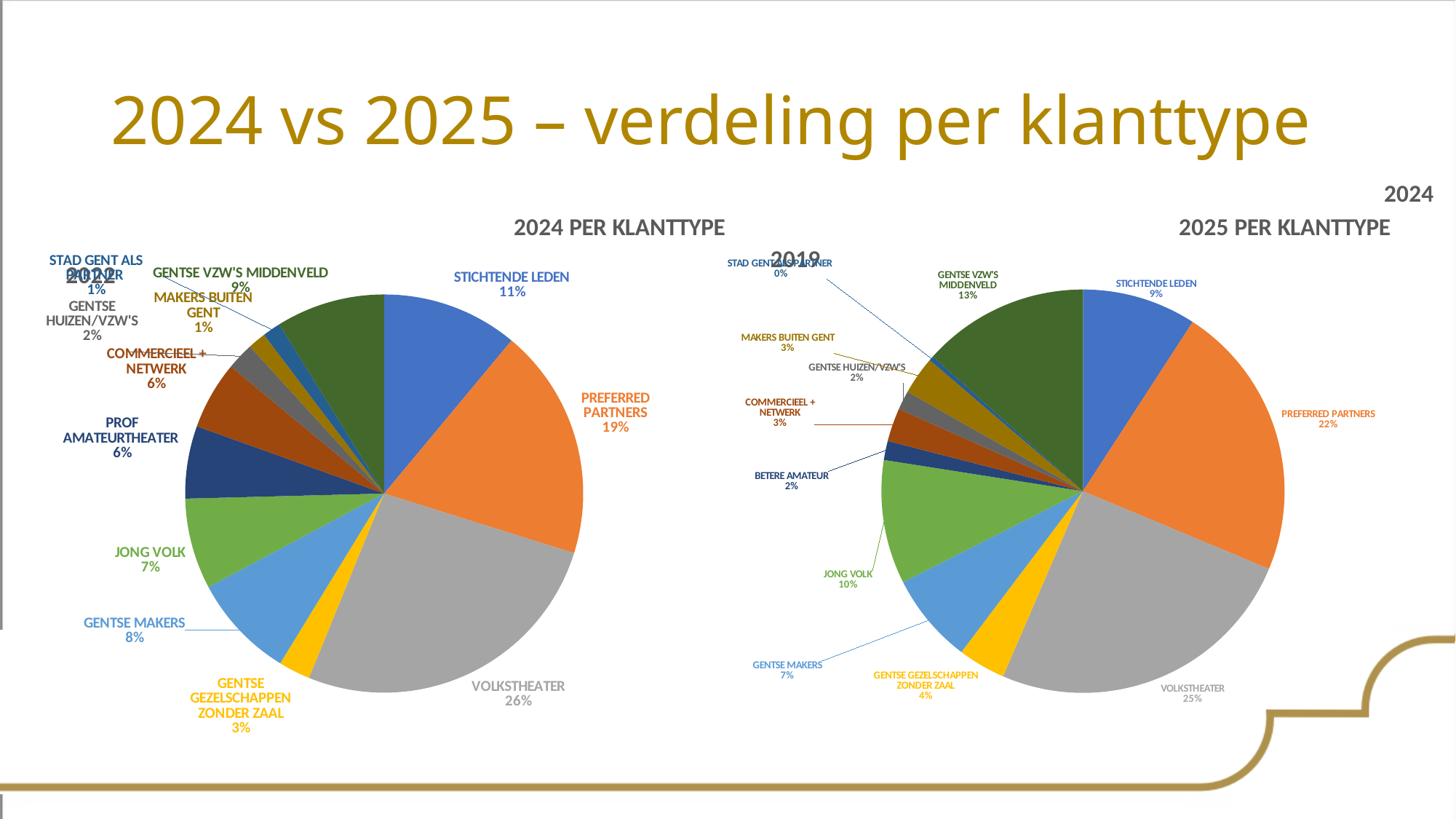
In the 2024 PER KLANTTYPE chart, which is larger: STICHTENDE LEDEN or GENTSE VZW'S MIDDENVELD? STICHTENDE LEDEN In the 2024 PER KLANTTYPE chart, what share does VOLKSTHEATER have? 26% In the 2024 PER KLANTTYPE chart, what is the difference in percentage points between VOLKSTHEATER and PREFERRED PARTNERS? 7 What is the title of the chart on the right side of the slide? 2025 PER KLANTTYPE In the 2024 PER KLANTTYPE chart, what share does JONG VOLK have? 7% In the 2025 PER KLANTTYPE chart, which is larger: JONG VOLK or GENTSE MAKERS? JONG VOLK In the 2025 PER KLANTTYPE chart, what share does PREFERRED PARTNERS have? 22% In the 2025 PER KLANTTYPE chart, which category has the smallest share? STAD GENT ALS PARTNER In the 2024 PER KLANTTYPE chart, which category has the largest share? VOLKSTHEATER In the 2025 PER KLANTTYPE chart, what share does GENTSE VZW'S MIDDENVELD have? 13% How many categories does the 2025 PER KLANTTYPE chart show? 12 What kind of chart is the 2024 PER KLANTTYPE chart? Pie chart